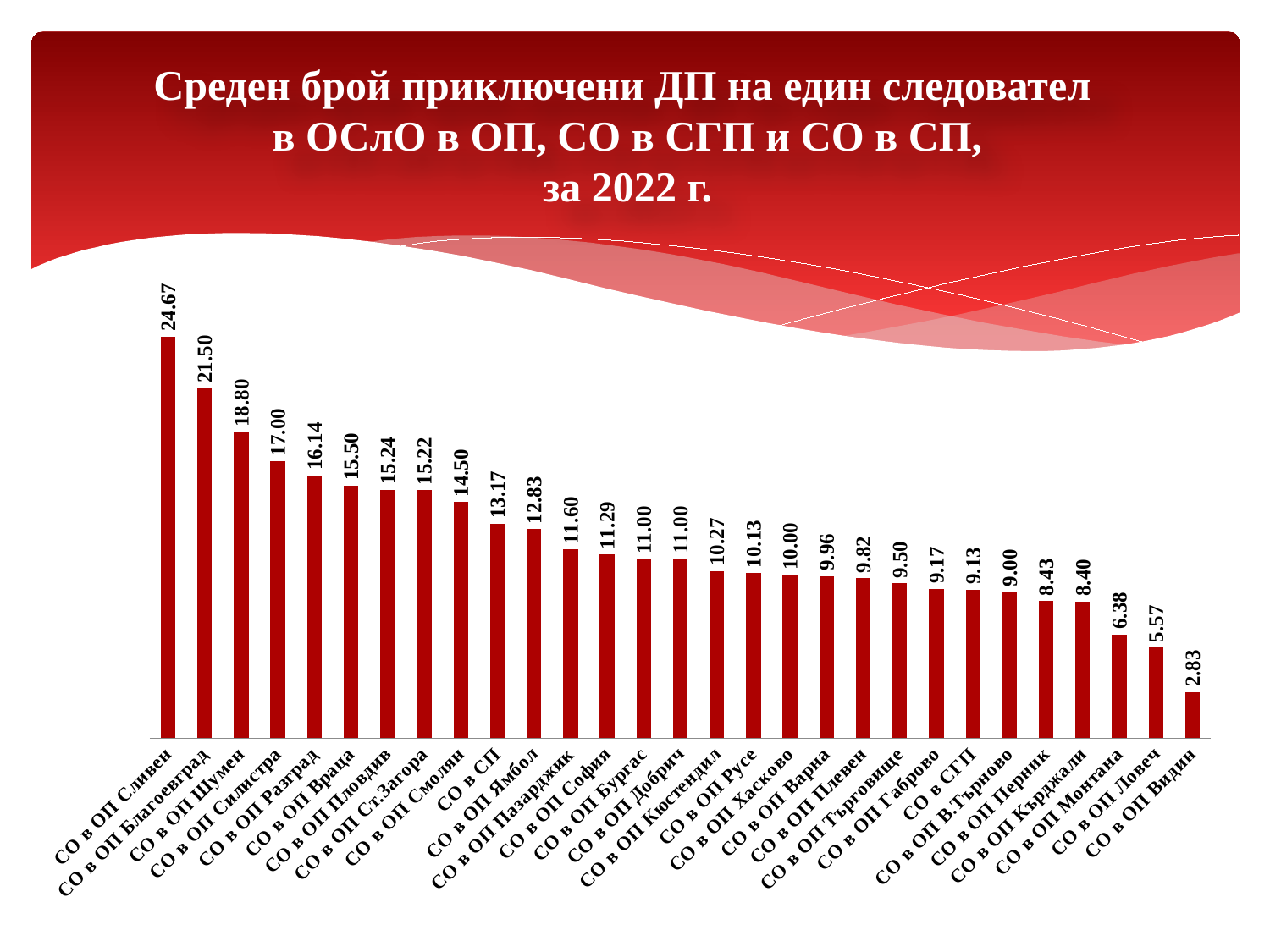
What is the value for СО в СГП? 9.13 Do the values rise or fall from left to right along the x axis? Fall What is the value for СО в ОП Кюстендил? 10.27 Which category has the lowest value? СО в ОП Видин What kind of chart is shown on the slide? Bar chart What is the value for СО в ОП Сливен? 24.67 What is the value for СО в СП? 13.17 What is the difference between the values for СО в ОП Сливен and СО в ОП Благоевград? 3.17 Which is larger, the value for СО в ОП Шумен or the value for СО в ОП Ямбол? СО в ОП Шумен What is the difference between the values for СО в ОП Монтана and СО в ОП Видин? 3.55 Which category has the highest value? СО в ОП Сливен How many categories are shown in the chart? 29